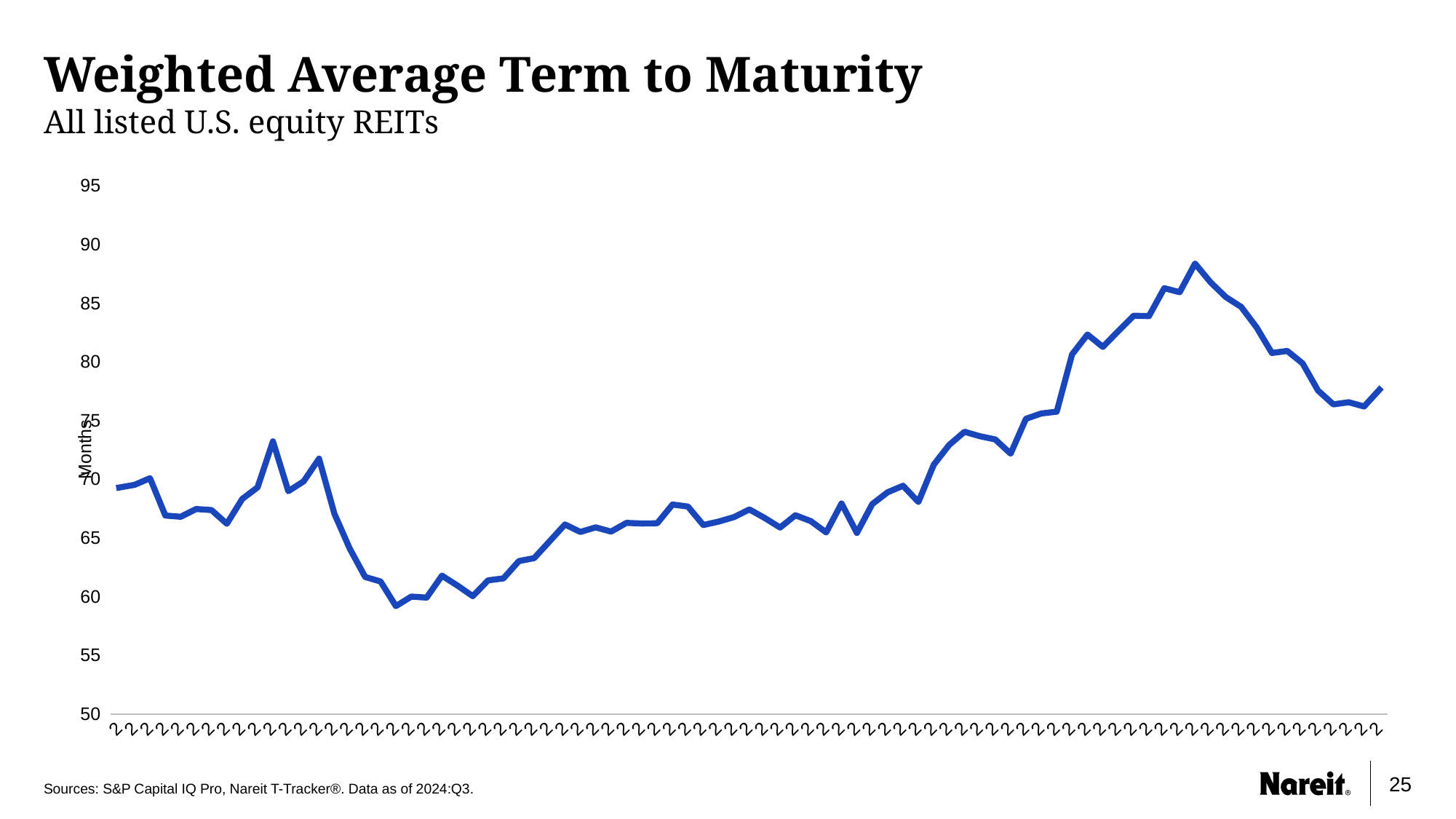
Overall, does the line rise or fall from the left end of the chart to the right end? rise Is the value at the right end of the line greater or less than 80? less What is the title of the chart? Weighted Average Term to Maturity How many data series are plotted on the chart? 1 Is the lowest point of the line greater or less than 65? less Is the value at the right end of the line greater or less than 75? greater What kind of chart is shown on the slide? line chart What unit is shown on the vertical axis label? Months Which is larger, the value at the left end of the line or the value at the right end? the right end What is the highest tick value shown on the vertical axis? 95